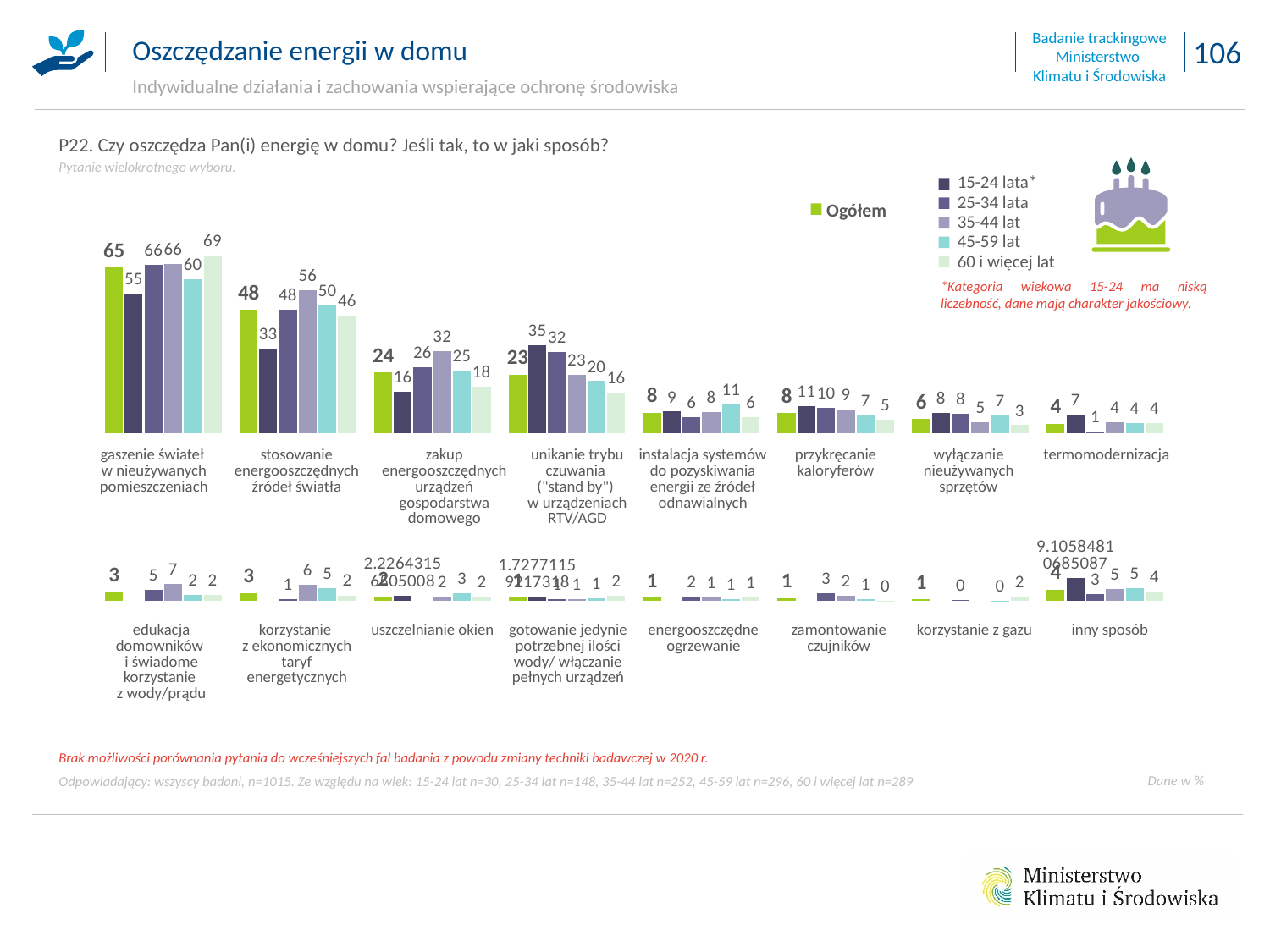
In the top chart, what is the Ogółem value for 'gaszenie świateł w nieużywanych pomieszczeniach'? 65 In the top chart, for 'zakup energooszczędnych urządzeń gospodarstwa domowego', which is larger: the value for 35-44 lat or for 15-24 lata? 35-44 lat In the top chart, which category has the lowest Ogółem value? termomodernizacja In the top chart, what is the difference between the Ogółem values for 'gaszenie świateł w nieużywanych pomieszczeniach' and 'stosowanie energooszczędnych źródeł światła'? 17 How many categories are shown in the top chart? 8 How many series does the legend list for the charts? 6 What colour represents the Ogółem series in the legend? green In the top chart, which category has the highest Ogółem value? gaszenie świateł w nieużywanych pomieszczeniach What kind of chart is the top chart on the slide? bar chart In the top chart, what is the value for 60 i więcej lat for 'gaszenie świateł w nieużywanych pomieszczeniach'? 69 In the top chart, what is the value for 15-24 lata for 'unikanie trybu czuwania ("stand by") w urządzeniach RTV/AGD'? 35 In the bottom chart, what is the Ogółem value for 'inny sposób'? 4